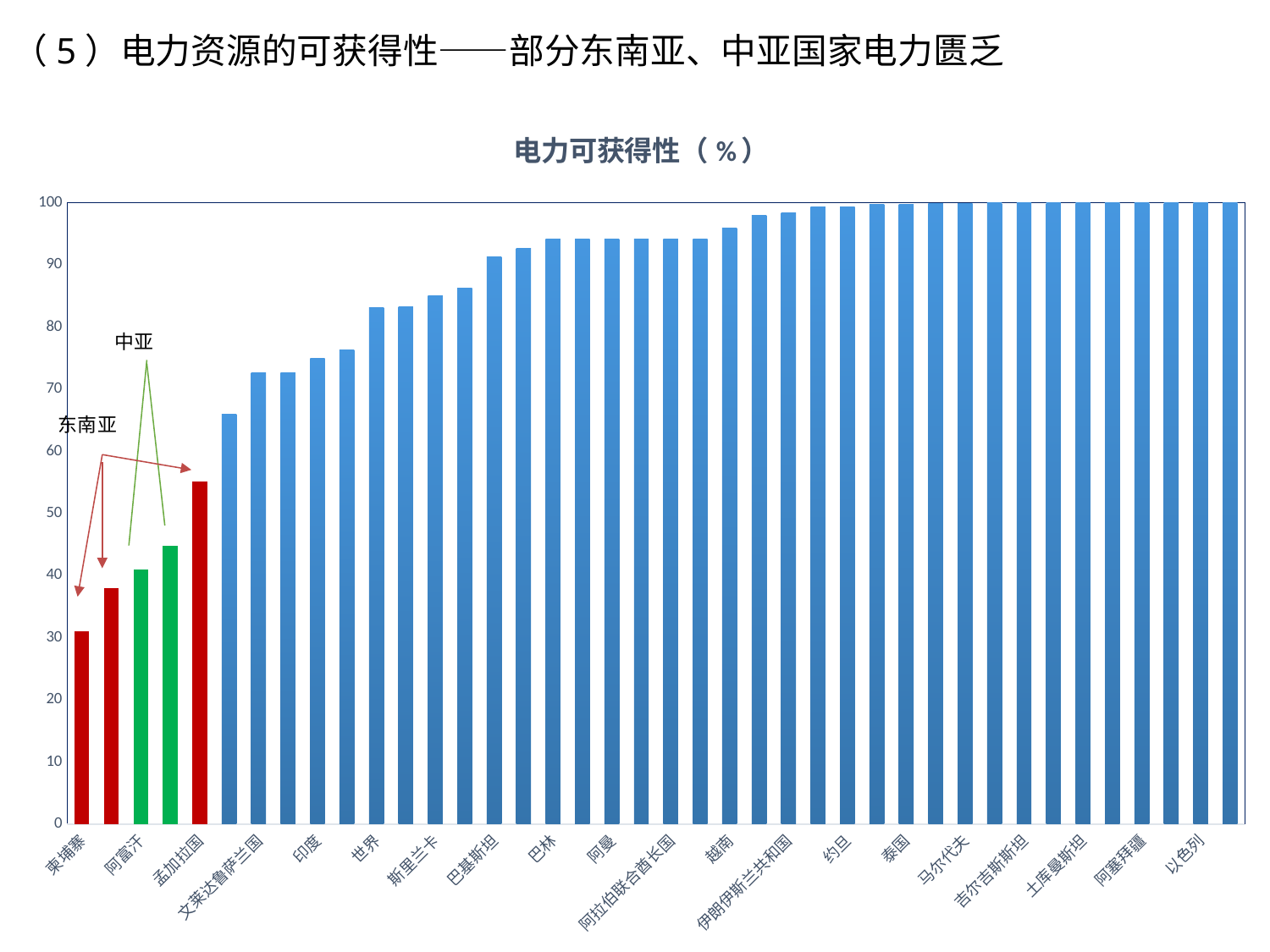
Is the value for 以色列 greater or less than 90? greater Is the value for 阿富汗 greater or less than 50? less Which region do the green bars represent according to the annotation? 中亚 Which has a higher value, 柬埔寨 or 孟加拉国? 孟加拉国 What is the title of the chart? 电力可获得性（%） Which has a higher value, 柬埔寨 or 以色列? 以色列 What kind of chart is shown on the slide? bar chart Is the value for 印度 greater or less than 70? greater Which labelled country has the lowest electricity accessibility in the chart? 柬埔寨 Do the bar values rise or fall from left to right along the x axis? rise